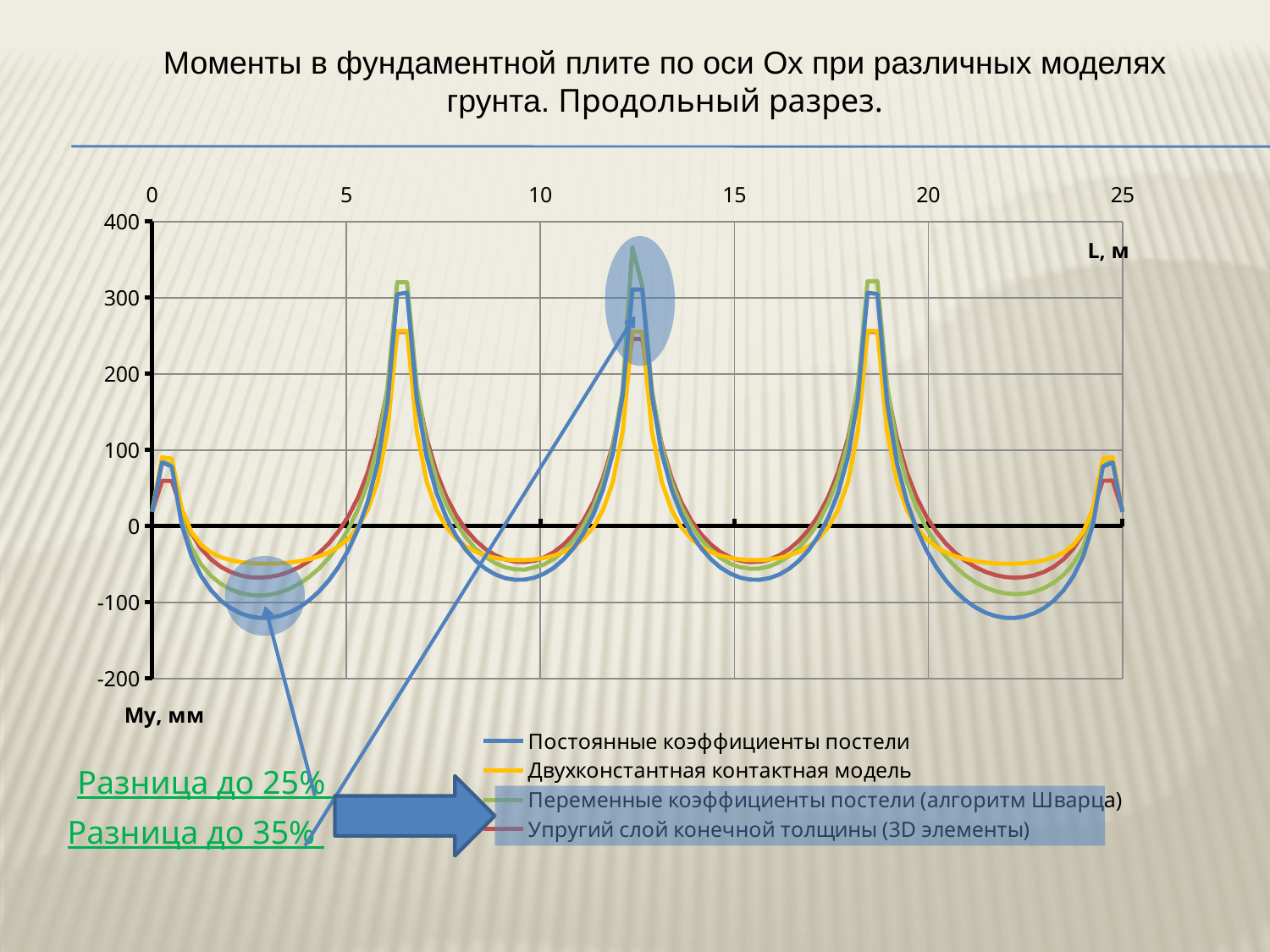
Is the peak value of the 'Двухконстантная контактная модель' series near L = 12.5 greater or less than 300? less Which series reaches the lowest (most negative) value on the chart? Постоянные коэффициенты постели Is the minimum value of the 'Постоянные коэффициенты постели' series near L = 21.5 greater or less than -100? less At the peak near L = 12.5, which series has the larger value: 'Переменные коэффициенты постели (алгоритм Шварца)' or 'Двухконстантная контактная модель'? Переменные коэффициенты постели (алгоритм Шварца) Is the minimum value of the 'Двухконстантная контактная модель' series near L = 3 greater or less than -100? greater What is the label shown on the horizontal axis of the chart? L, м At the peak near L = 6.5, which series has the larger value: 'Постоянные коэффициенты постели' or 'Двухконстантная контактная модель'? Постоянные коэффициенты постели Which series reaches the highest peak value on the chart? Переменные коэффициенты постели (алгоритм Шварца) What is the label shown on the vertical axis of the chart? My, мм How many series does the legend list? 4 What kind of chart is shown on the slide? line chart